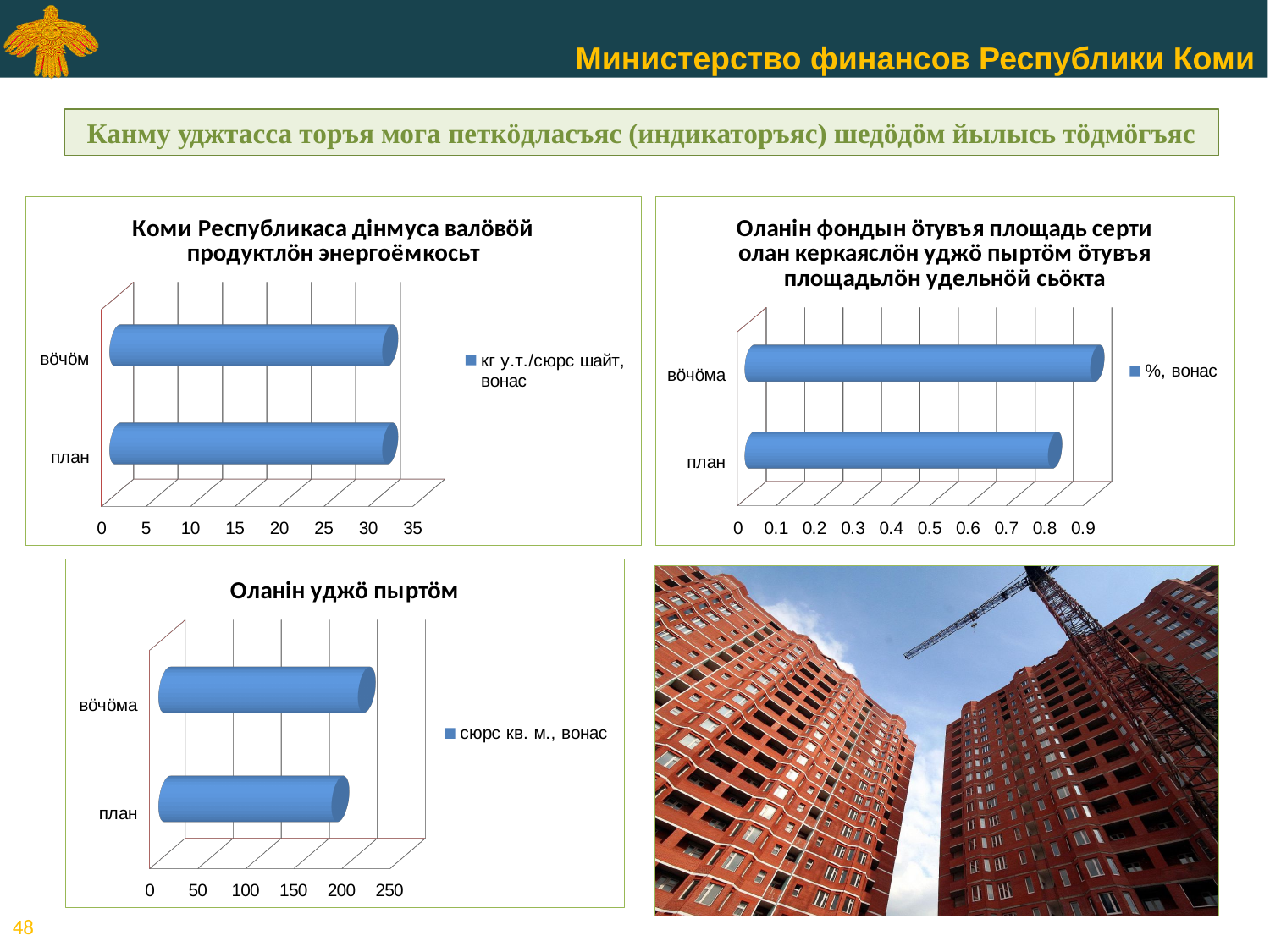
What is the legend entry in the chart titled "Коми Республикаса дінмуса валöвöй продуктлöн энергоёмкосьт"? кг у.т./сюрс шайт, вонас How many categories are shown in the chart titled "Оланін уджö пыртöм"? 2 What kind of chart is the chart titled "Оланін уджö пыртöм"? bar chart What is the legend entry in the chart titled "Оланін уджö пыртöм"? сюрс кв. м., вонас How many series does the legend list in the top-right chart (Оланін фондын öтувъя площадь серти...)? 1 In the chart titled "Оланін уджö пыртöм", is the value for вöчöма greater or less than 200? greater In the top-right chart (Оланін фондын öтувъя площадь серти...), is the value for план greater or less than 0.7? greater In the chart titled "Оланін уджö пыртöм", is the value for план greater or less than 250? less In the chart titled "Оланін уджö пыртöм", which category has the higher value, вöчöма or план? вöчöма In the top-right chart (Оланін фондын öтувъя площадь серти...), which category has the higher value, вöчöма or план? вöчöма